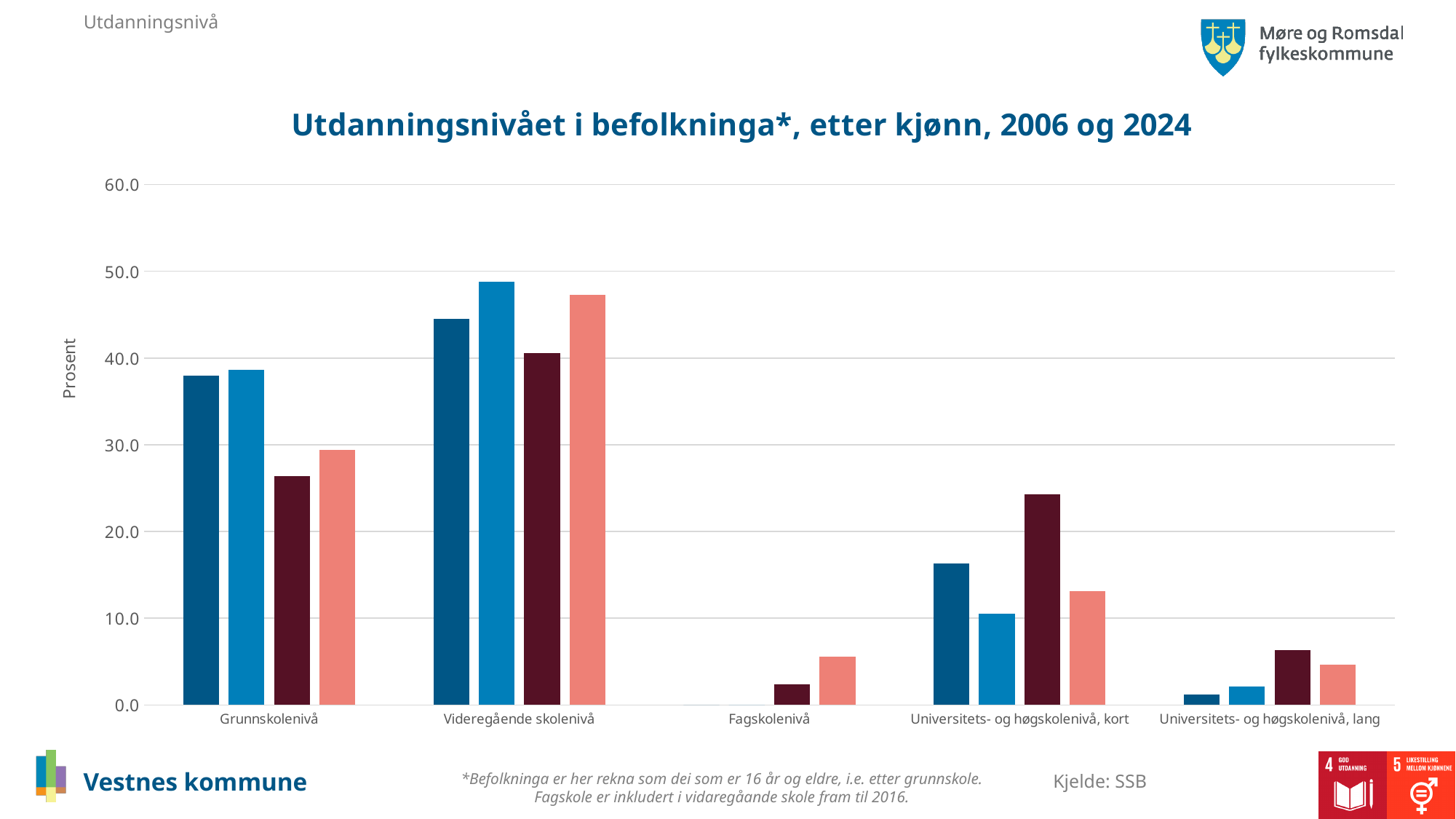
What kind of chart is shown on the slide? bar chart How many bars are plotted for each category? 4 For Grunnskolenivå, which is larger: the dark red (third) bar or the salmon (fourth) bar? the salmon (fourth) bar For Universitets- og høgskolenivå, kort, which is larger: the dark blue (first) bar or the light blue (second) bar? the dark blue (first) bar Is the value of the dark blue (first) bar for Grunnskolenivå greater or less than 40? less How many education-level categories are shown on the x axis? 5 What is the title of the chart? Utdanningsnivået i befolkninga*, etter kjønn, 2006 og 2024 Which category has the lowest bars overall? Fagskolenivå Is the value of the dark red (third) bar for Universitets- og høgskolenivå, kort greater or less than 20? greater What is the label on the vertical axis? Prosent Which category has the tallest bars overall? Videregående skolenivå Is the value of the salmon (fourth) bar for Fagskolenivå greater or less than 10? less